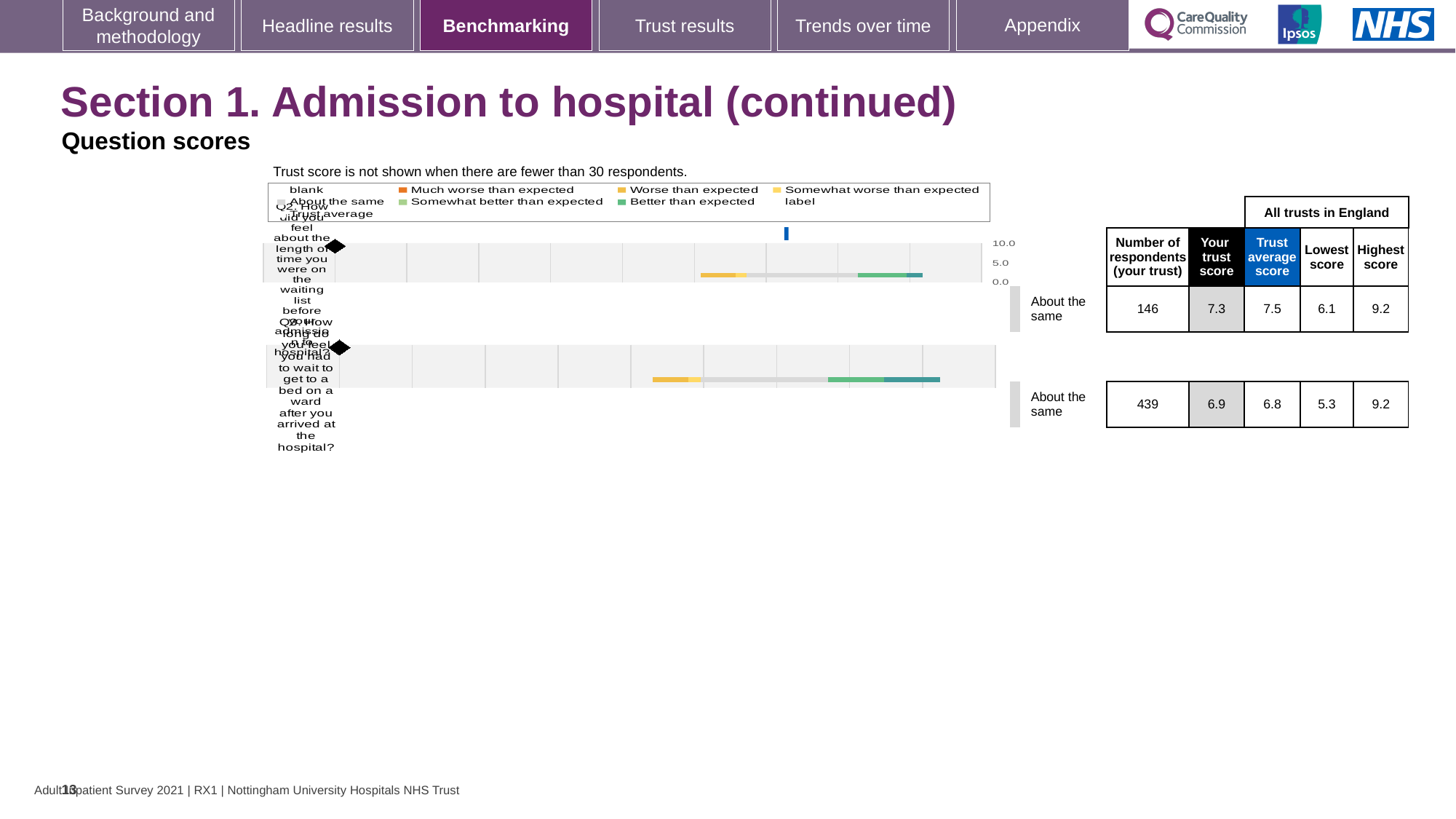
How many respondents answered Q3 for this trust? 439 What is the trust score for Q3 (how long did you feel you had to wait to get to a bed on a ward after you arrived at the hospital)? 6.9 Which question has the higher trust score for this trust, Q2 or Q3? Q2 What is the difference between the trust average score and this trust's score for Q2? 0.2 What is the trust score for Q2 (how did you feel about the length of time you were on the waiting list before admission)? 7.3 What is the highest score across all trusts in England for Q2? 9.2 What is the trust average score across all trusts in England for Q2? 7.5 What kind of chart is used to show the question scores on this slide? bar chart How many questions are plotted on this slide? 2 What is the lowest score across all trusts in England for Q3? 5.3 How many respondents answered Q2 for this trust? 146 Is the trust score for Q3 greater or less than 5.0 on the chart axis? greater